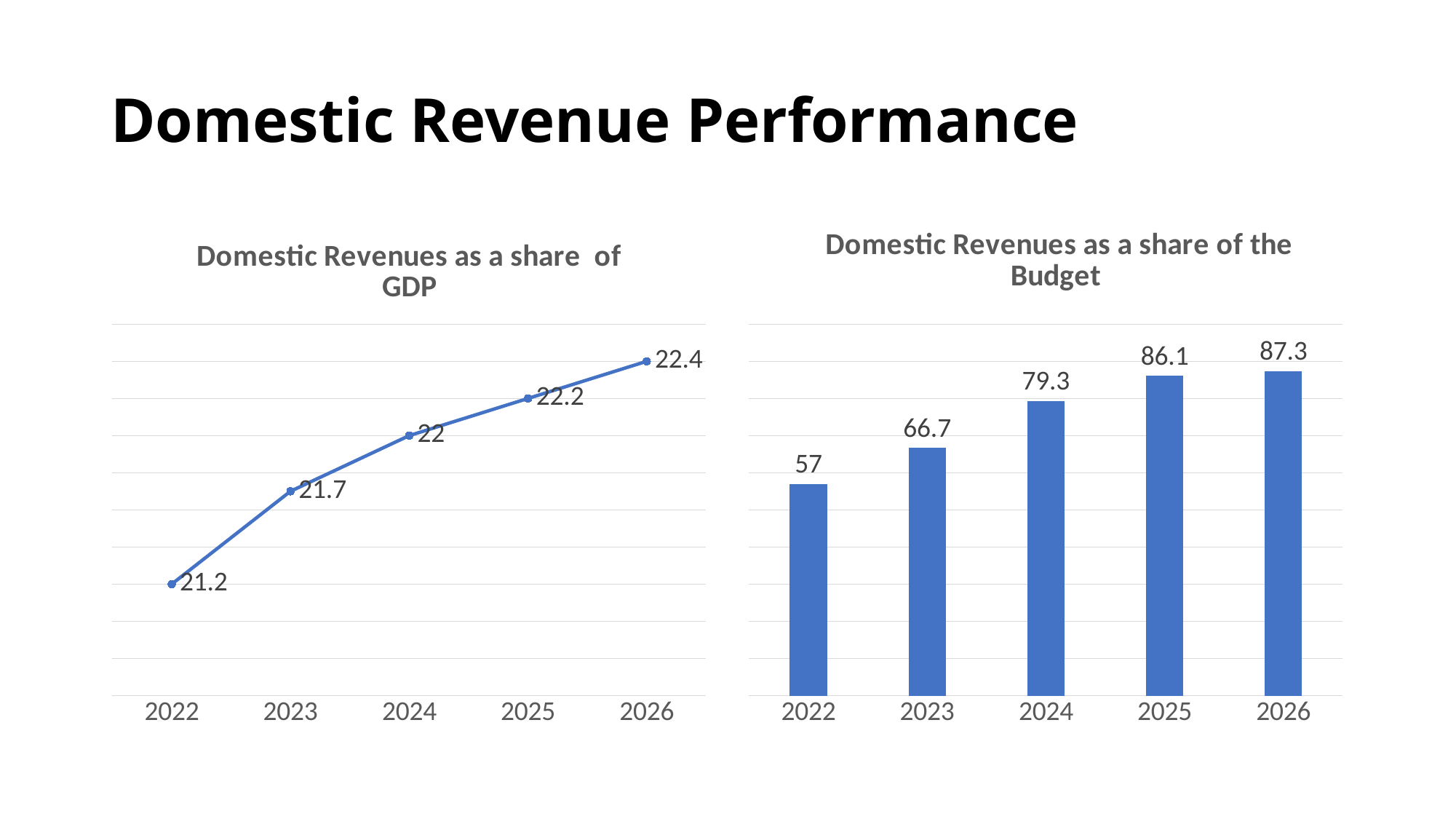
How many years are shown on the x axis of the 'Domestic Revenues as a share of GDP' chart? 5 In the 'Domestic Revenues as a share of the Budget' chart, what is the value for 2023? 66.7 In the 'Domestic Revenues as a share of GDP' chart, what is the value for 2022? 21.2 What kind of chart is 'Domestic Revenues as a share of the Budget'? Bar chart In the 'Domestic Revenues as a share of the Budget' chart, which year has the lowest value? 2022 In the 'Domestic Revenues as a share of GDP' chart, do the values rise or fall from 2022 to 2026? Rise In the 'Domestic Revenues as a share of GDP' chart, which year has the highest value? 2026 In the 'Domestic Revenues as a share of the Budget' chart, what is the value for 2026? 87.3 In the 'Domestic Revenues as a share of GDP' chart, what is the value for 2024? 22 In the 'Domestic Revenues as a share of GDP' chart, what is the difference between the 2026 and 2022 values? 1.2 In the 'Domestic Revenues as a share of the Budget' chart, which is larger, the value for 2023 or the value for 2025? 2025 In the 'Domestic Revenues as a share of the Budget' chart, what is the difference between the 2024 and 2022 values? 22.3